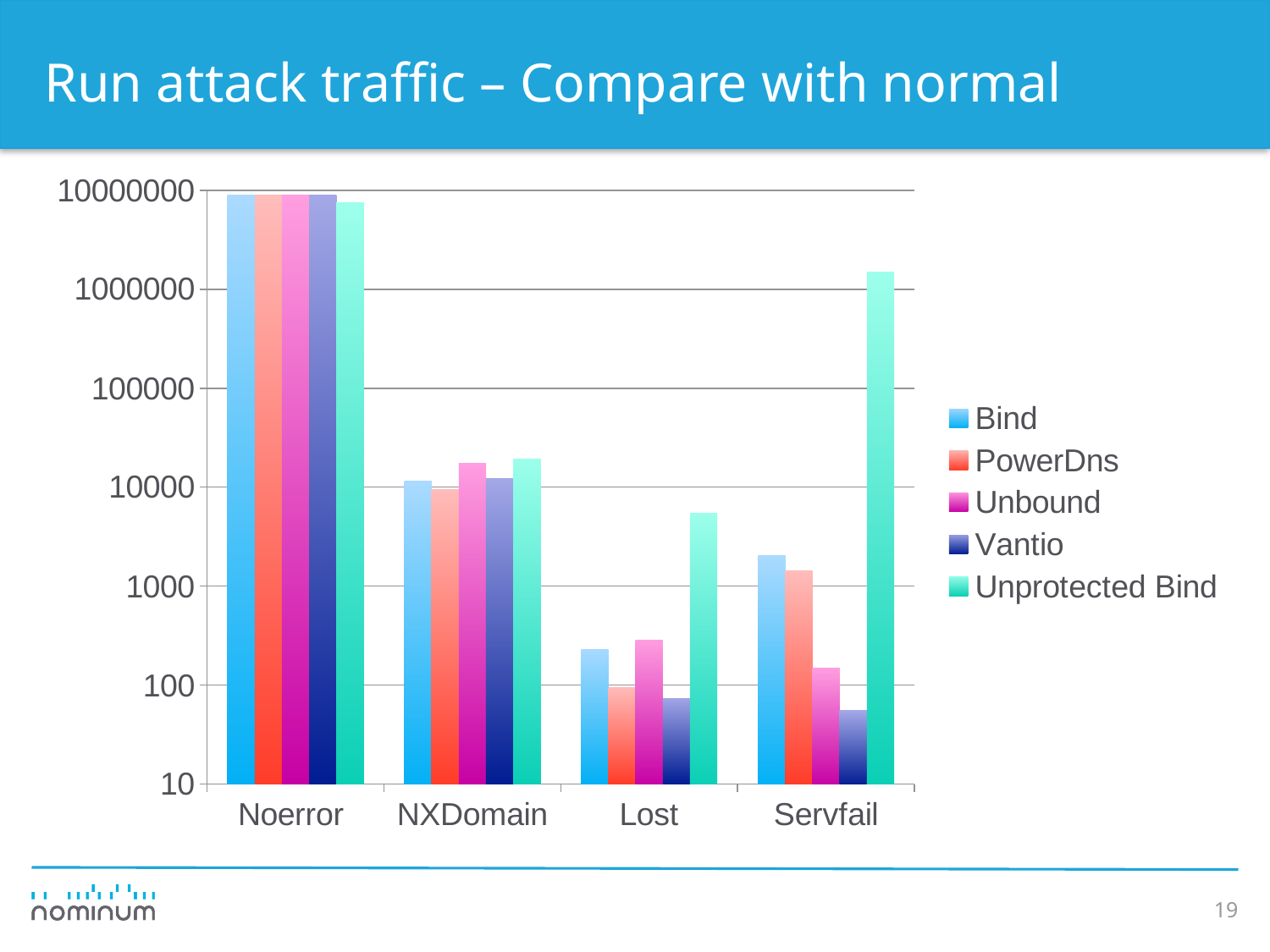
Which series has the highest value for Lost? Unprotected Bind What kind of chart is shown on the slide? bar chart For Servfail, which is larger: the value for Bind or the value for PowerDns? Bind Which series is shown in green in the chart's legend? Unprotected Bind Which series has the highest value for Servfail? Unprotected Bind Which series has the lowest value for Servfail? Vantio Is the value for Vantio in the Servfail category greater or less than 100? less Is the value for Unprotected Bind in the Servfail category greater or less than 1000000? greater What is the title of the slide containing the chart? Run attack traffic – Compare with normal Is the value for Unprotected Bind in the Lost category greater or less than 1000? greater How many series does the chart's legend list? 5 How many categories are shown on the x axis of the chart? 4